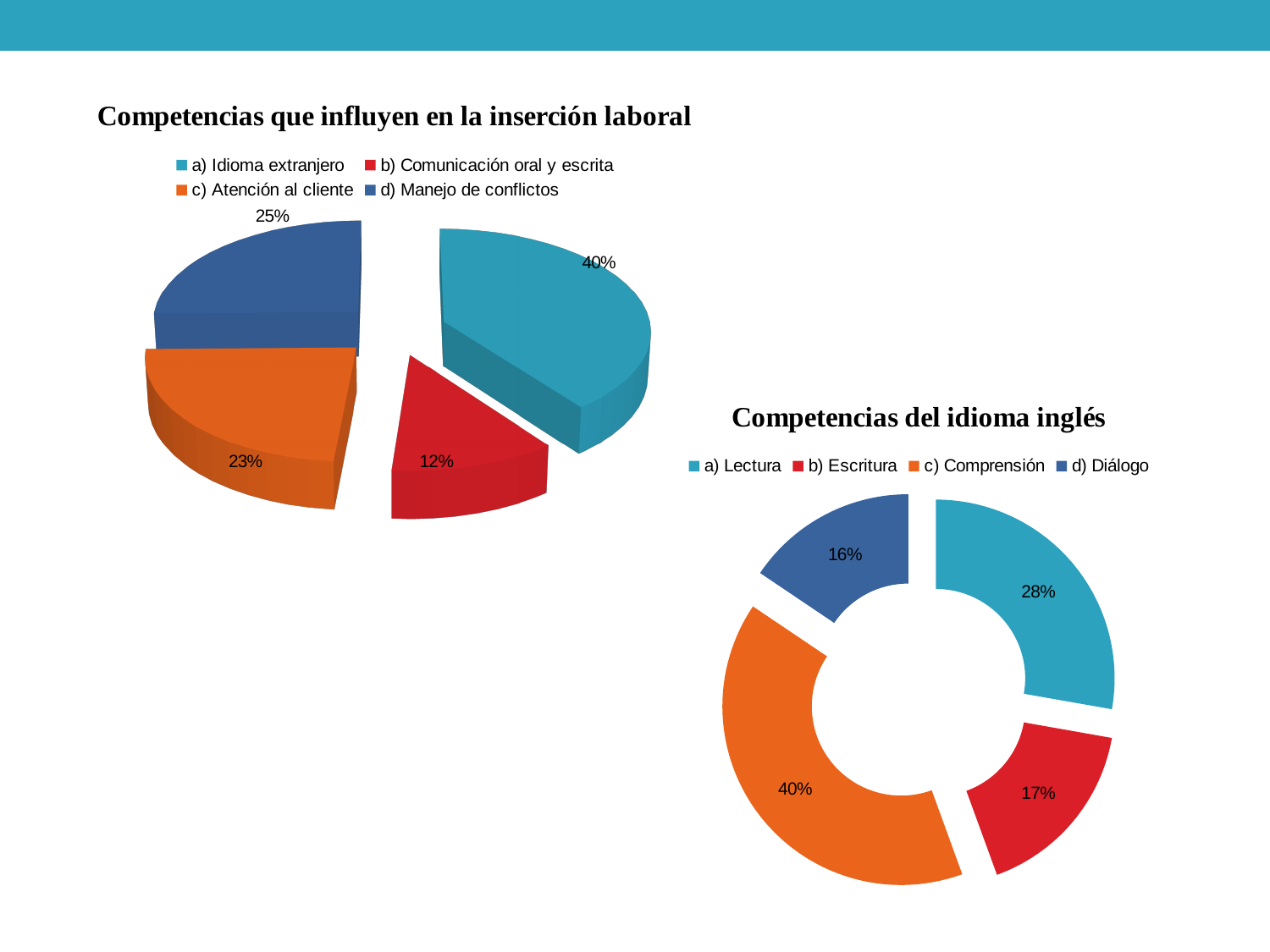
What kind of chart is 'Competencias del idioma inglés'? Doughnut chart In the 'Competencias que influyen en la inserción laboral' chart, how many categories are shown? 4 In the 'Competencias que influyen en la inserción laboral' chart, what percentage is shown for a) Idioma extranjero? 40% In the 'Competencias que influyen en la inserción laboral' chart, what percentage is shown for c) Atención al cliente? 23% What kind of chart is 'Competencias que influyen en la inserción laboral'? Pie chart In the 'Competencias que influyen en la inserción laboral' chart, which category has the smallest share? b) Comunicación oral y escrita In the 'Competencias del idioma inglés' chart, what is the difference in percentage points between c) Comprensión and a) Lectura? 12 In the 'Competencias del idioma inglés' chart, what percentage is shown for c) Comprensión? 40% In the 'Competencias del idioma inglés' chart, what percentage is shown for d) Diálogo? 16% In the 'Competencias que influyen en la inserción laboral' chart, which category has the largest share? a) Idioma extranjero In the 'Competencias que influyen en la inserción laboral' chart, what is the difference in percentage points between d) Manejo de conflictos and b) Comunicación oral y escrita? 13 In the 'Competencias del idioma inglés' chart, which is larger, a) Lectura or b) Escritura? a) Lectura